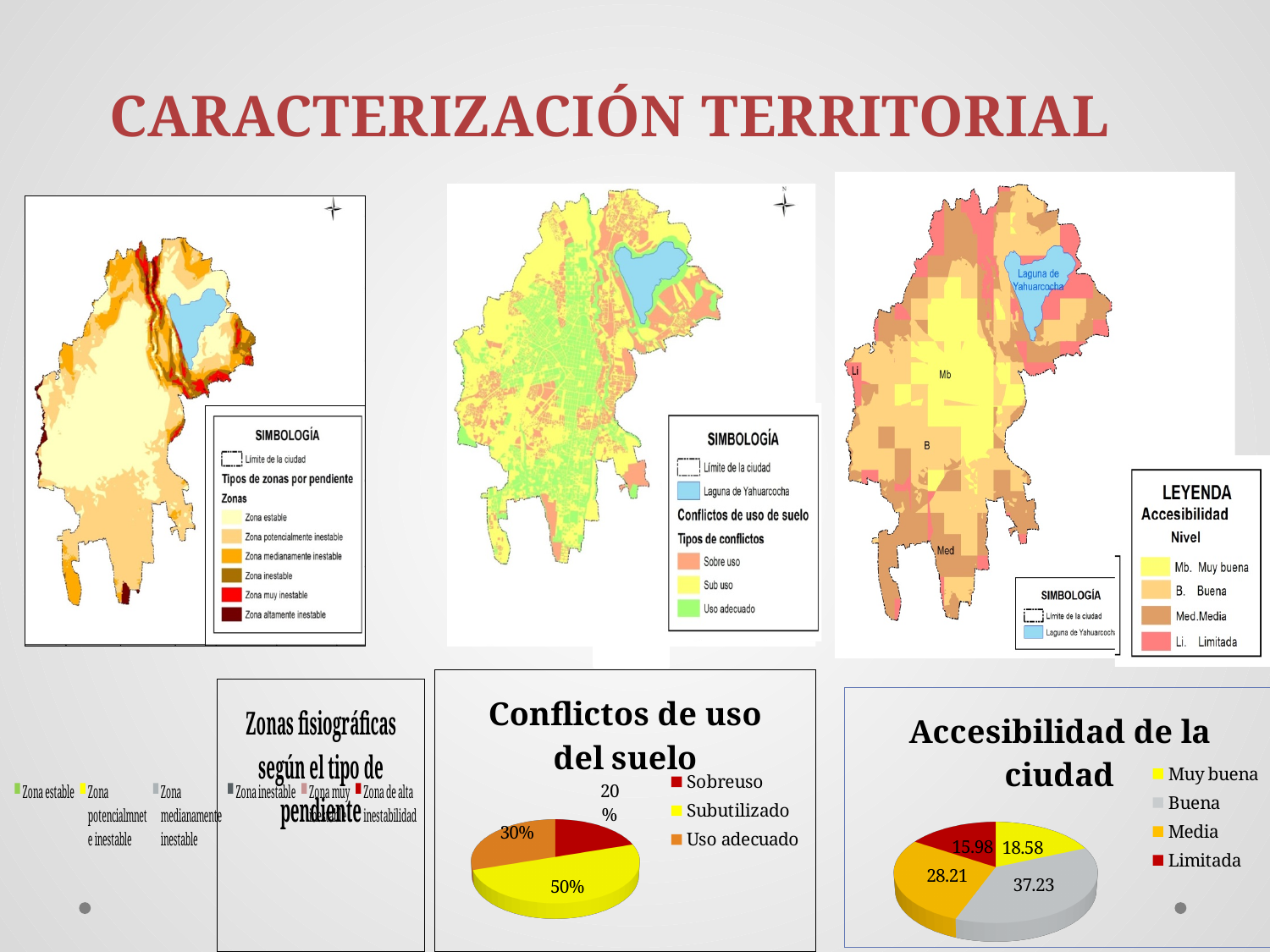
In the 'Conflictos de uso del suelo' chart, what percentage is shown for Sobreuso? 20% How many categories does the legend of the 'Accesibilidad de la ciudad' chart list? 4 In the 'Conflictos de uso del suelo' chart, what percentage is shown for Uso adecuado? 30% In the 'Accesibilidad de la ciudad' chart, what value is shown for Limitada? 15.98 In the 'Accesibilidad de la ciudad' chart, which category has the smallest value? Limitada What kind of chart is 'Conflictos de uso del suelo'? Pie chart In the 'Accesibilidad de la ciudad' chart, which is larger, Media or Muy buena? Media In the 'Accesibilidad de la ciudad' chart, what is the difference between the values for Buena and Media? 9.02 In the 'Accesibilidad de la ciudad' chart, what value is shown for Buena? 37.23 In the 'Conflictos de uso del suelo' chart, which category has the largest share? Subutilizado In the 'Conflictos de uso del suelo' chart, what percentage is shown for Subutilizado? 50% In the 'Conflictos de uso del suelo' chart, what is the difference between the Subutilizado and Sobreuso shares? 30%